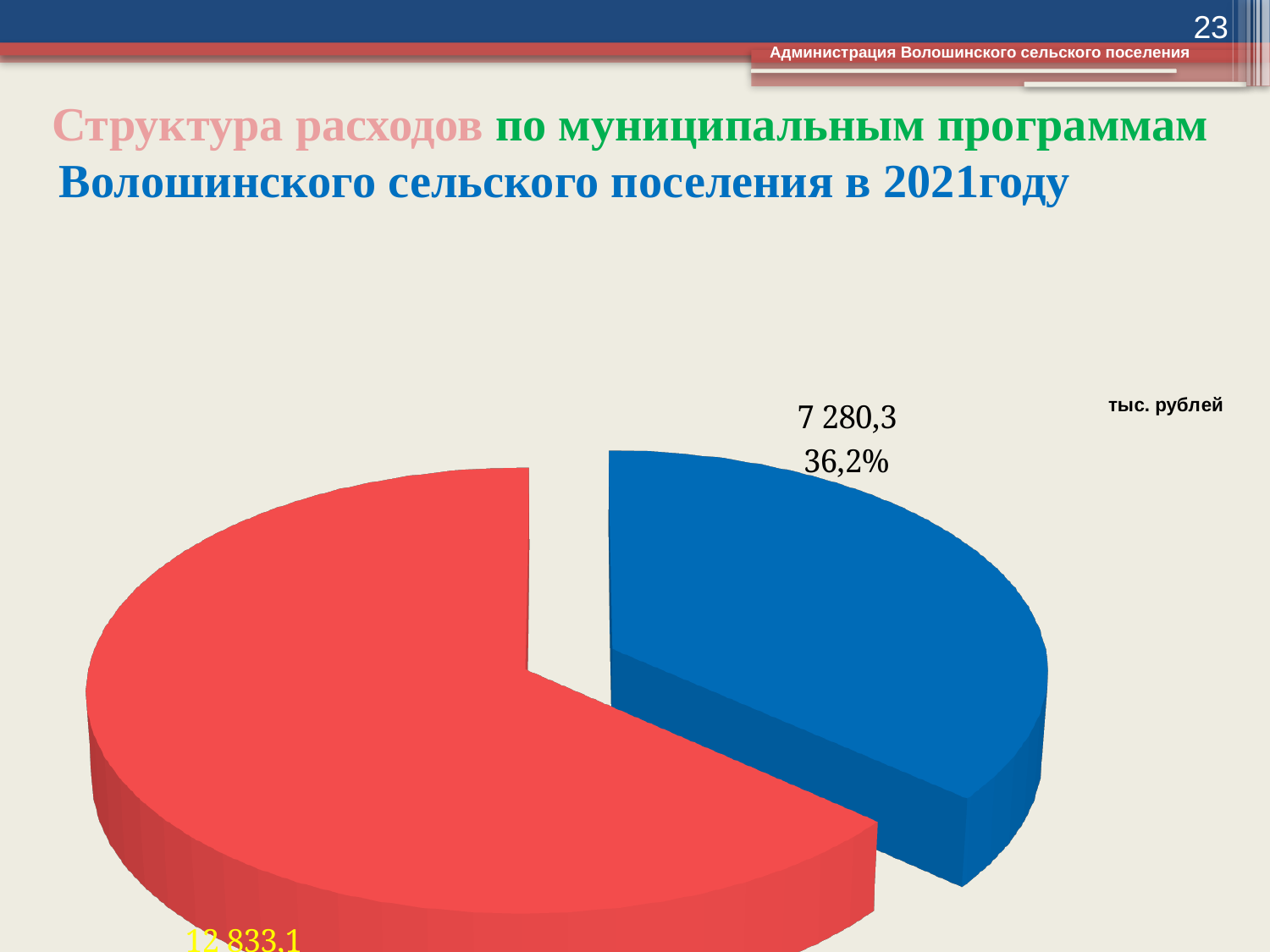
What value is printed on the red slice of the pie chart? 12 833,1 What is the total of the two slice values shown on the pie chart? 20 113,4 What is the difference between the red slice value (12 833,1) and the blue slice value (7 280,3)? 5 552,8 Which is larger, the red slice or the blue slice? the red slice What unit of measurement is indicated next to the pie chart? тыс. рублей Which slice of the pie chart is the smallest? the blue slice (7 280,3) What colours are the two slices of the pie chart? red and blue How many slices does the pie chart have? 2 What percentage share is printed for the blue slice of the pie chart? 36,2% What kind of chart is shown on the slide? pie chart What value is printed on the blue slice of the pie chart? 7 280,3 Which slice of the pie chart is the largest? the red slice (12 833,1)